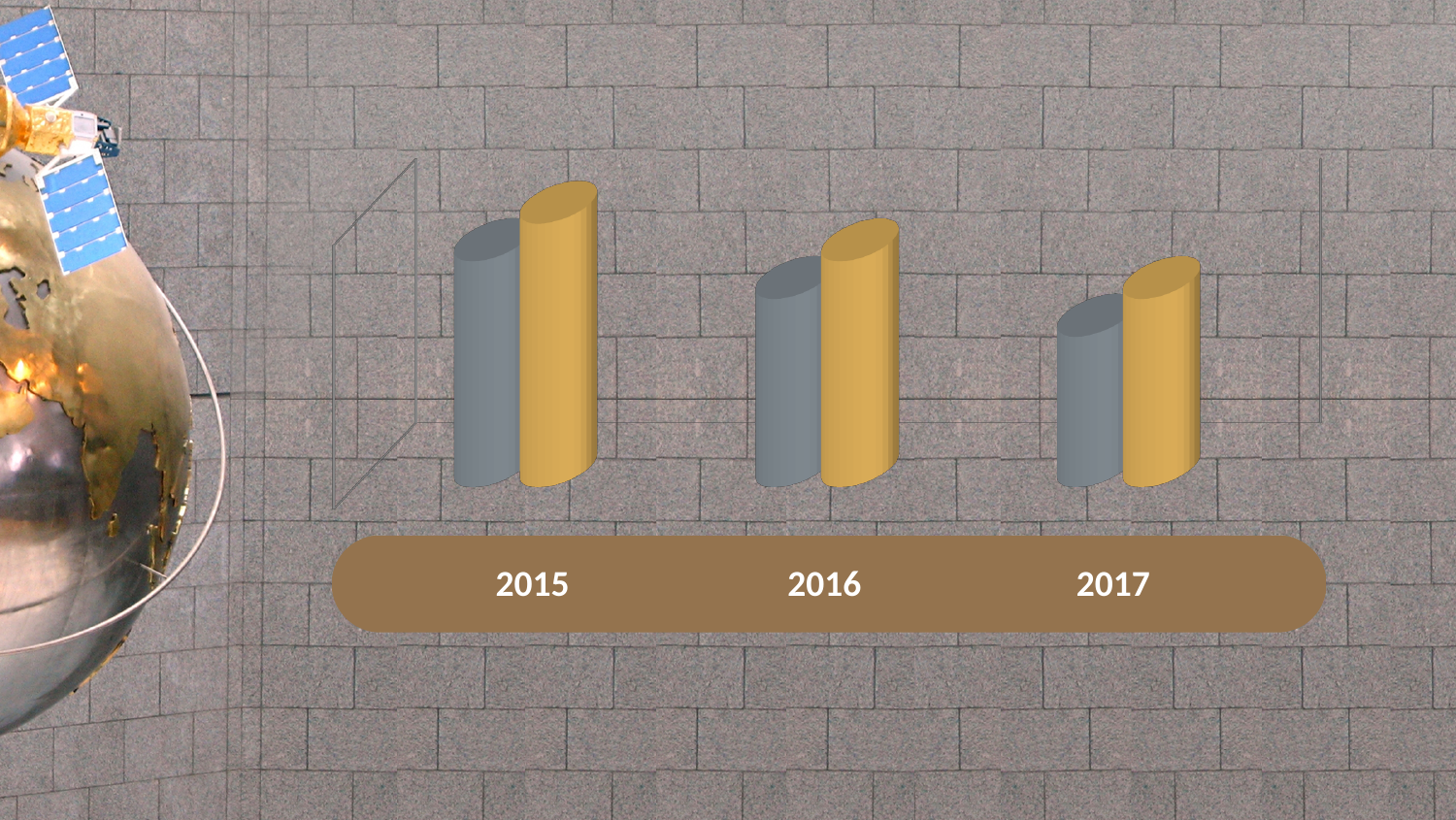
Which year has the shortest gold bar? 2017 What kind of chart is shown on the slide? bar chart Which year has the tallest grey bar? 2015 Which year has the shortest grey bar? 2017 In 2016, which bar is taller, the grey bar or the gold bar? the gold bar Do the values of the gold bars rise or fall from 2015 to 2017? fall Which year has the tallest gold bar? 2015 How many categories are shown on the x axis of the chart? 3 Do the values of the grey bars rise or fall from 2015 to 2017? fall Which years are shown as categories on the chart? 2015, 2016, 2017 How many bars are shown for each year on the chart? 2 Is the grey bar for 2015 taller or shorter than the grey bar for 2017? taller